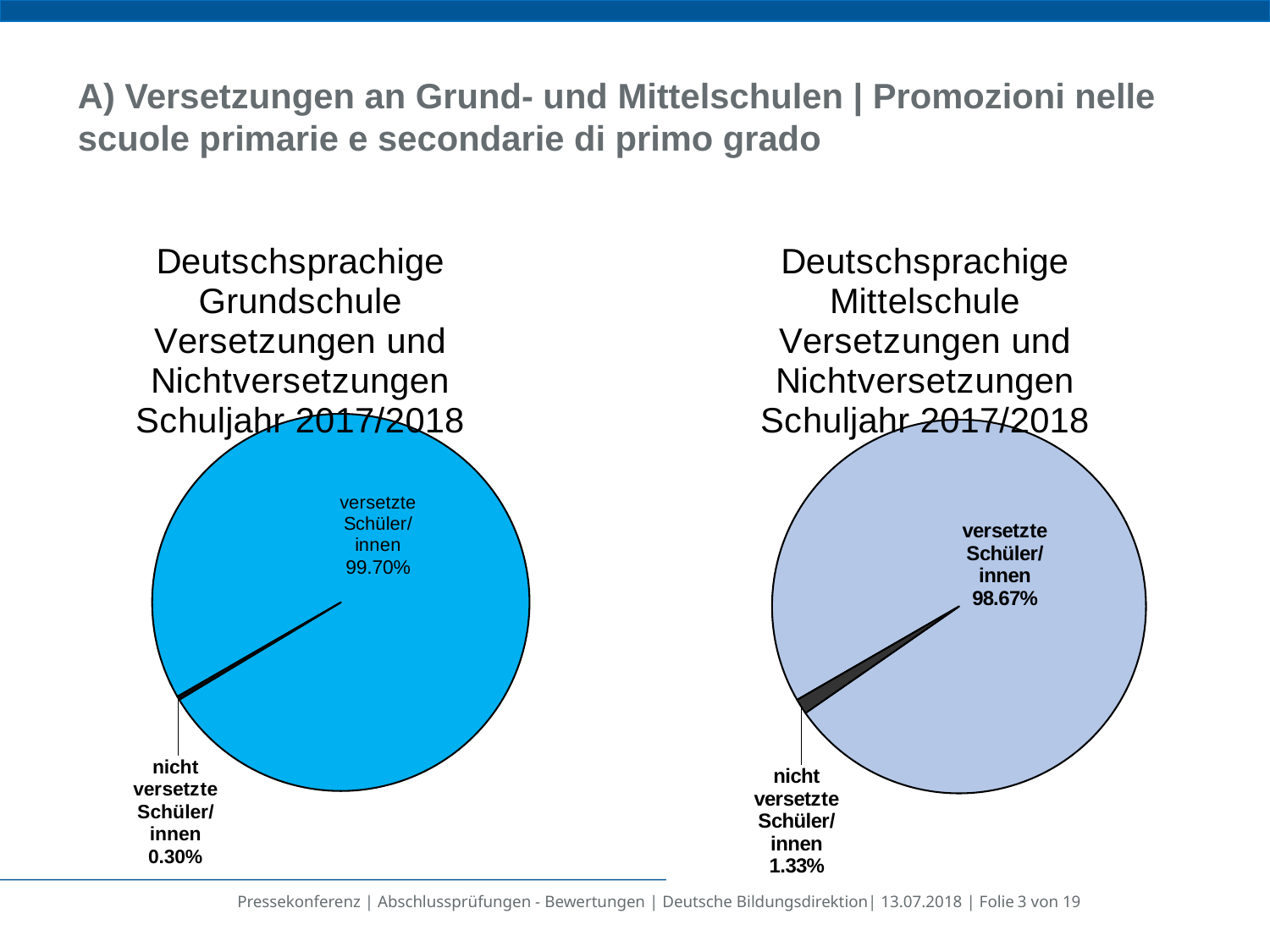
What type of chart is used on the left for the Deutschsprachige Grundschule? Pie chart What is the difference in percentage points between the non-promoted share in the right chart (Mittelschule) and the left chart (Grundschule)? 1.03 percentage points Which school has the higher share of non-promoted pupils, the Grundschule (left chart) or the Mittelschule (right chart)? Mittelschule Which school year do both pie charts refer to? Schuljahr 2017/2018 In the left pie chart (Deutschsprachige Grundschule), which slice is the largest? versetzte Schüler/innen In the right pie chart (Deutschsprachige Mittelschule), what share of pupils were promoted (versetzte Schüler/innen)? 98.67% In the right pie chart (Deutschsprachige Mittelschule), which slice is the smallest? nicht versetzte Schüler/innen How many slices does the right pie chart (Deutschsprachige Mittelschule) have? 2 In the left pie chart (Deutschsprachige Grundschule), what share of pupils were not promoted (nicht versetzte Schüler/innen)? 0.30% What is the title of the right pie chart? Deutschsprachige Mittelschule Versetzungen und Nichtversetzungen Schuljahr 2017/2018 In the left pie chart (Deutschsprachige Grundschule), what share of pupils were promoted (versetzte Schüler/innen)? 99.70% In the right pie chart (Deutschsprachige Mittelschule), what share of pupils were not promoted (nicht versetzte Schüler/innen)? 1.33%